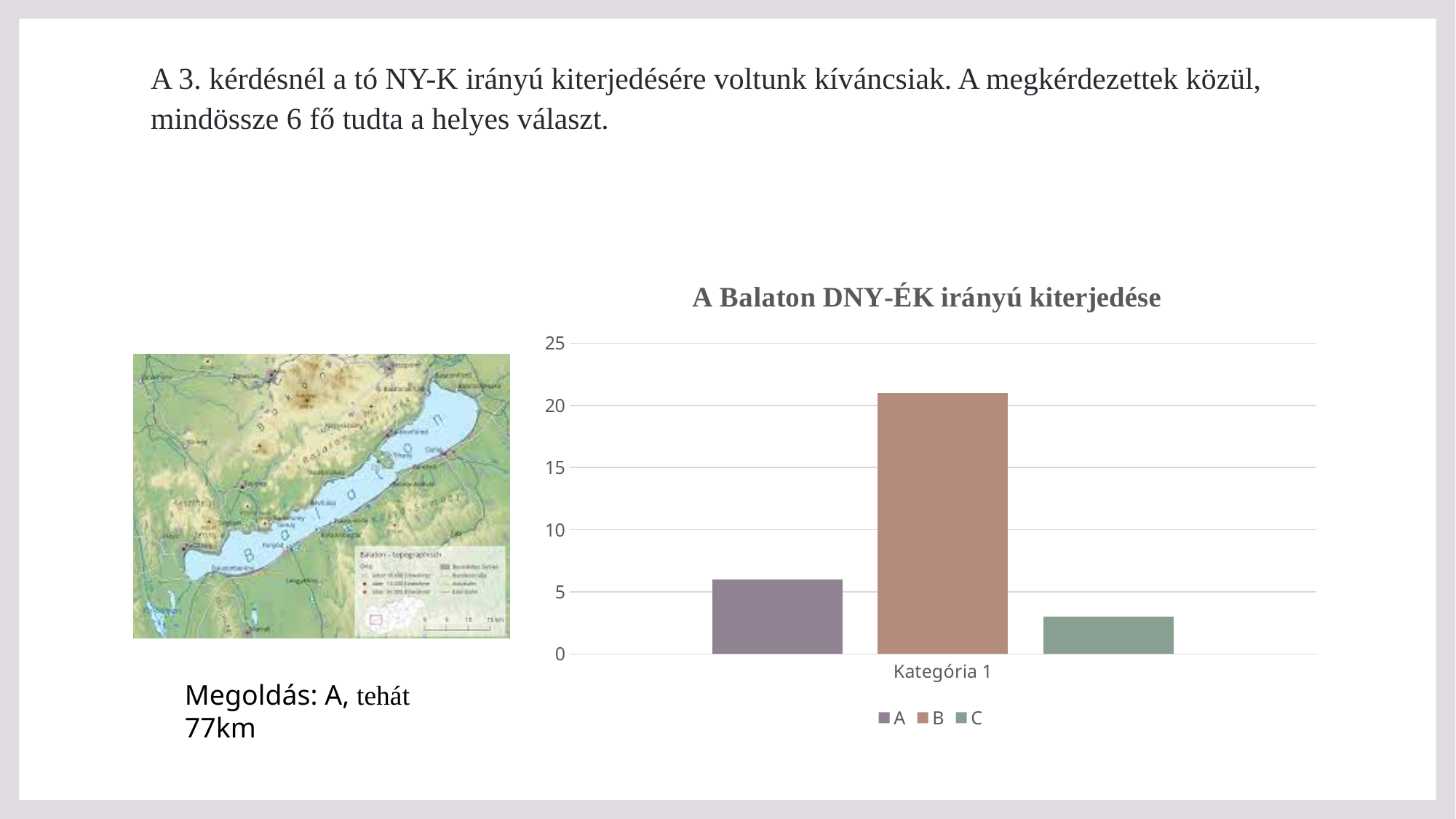
Which is larger in the chart, the value for A or the value for B? B Is the value for C greater or less than 5? less What kind of chart is shown on the slide? bar chart Which series has the lowest bar in the chart? C How many series does the legend of the chart list? 3 Is the value for B greater or less than 20? greater Is the value for A greater or less than 5? greater What is the label of the category on the x axis of the chart? Kategória 1 How many categories are shown on the x axis of the chart? 1 Which is larger in the chart, the value for A or the value for C? A Which series has the highest bar in the chart? B What is the title of the chart? A Balaton DNY-ÉK irányú kiterjedése